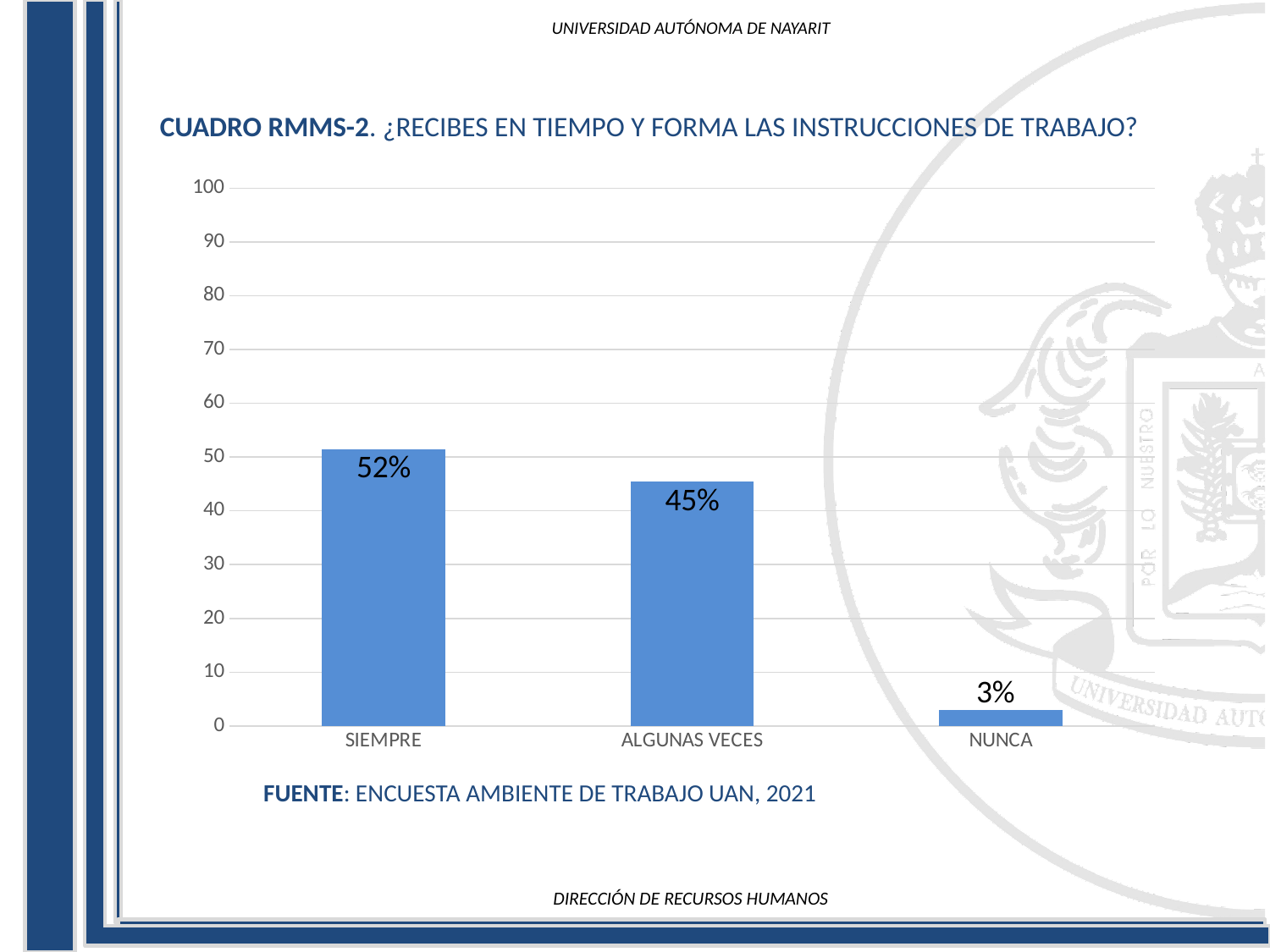
What is the value for ALGUNAS VECES? 45% Which category has the lowest value? NUNCA How many categories are shown on the x axis? 3 What is the value for SIEMPRE? 52% What is the value for NUNCA? 3% What source is cited below the chart? ENCUESTA AMBIENTE DE TRABAJO UAN, 2021 Is the value for ALGUNAS VECES greater or less than 50? less What is the difference between the values for SIEMPRE and ALGUNAS VECES? 7% What kind of chart is shown on the slide? bar chart What is the difference between the values for ALGUNAS VECES and NUNCA? 42% Which category has the highest value? SIEMPRE Which is larger, the value for SIEMPRE or the value for NUNCA? SIEMPRE